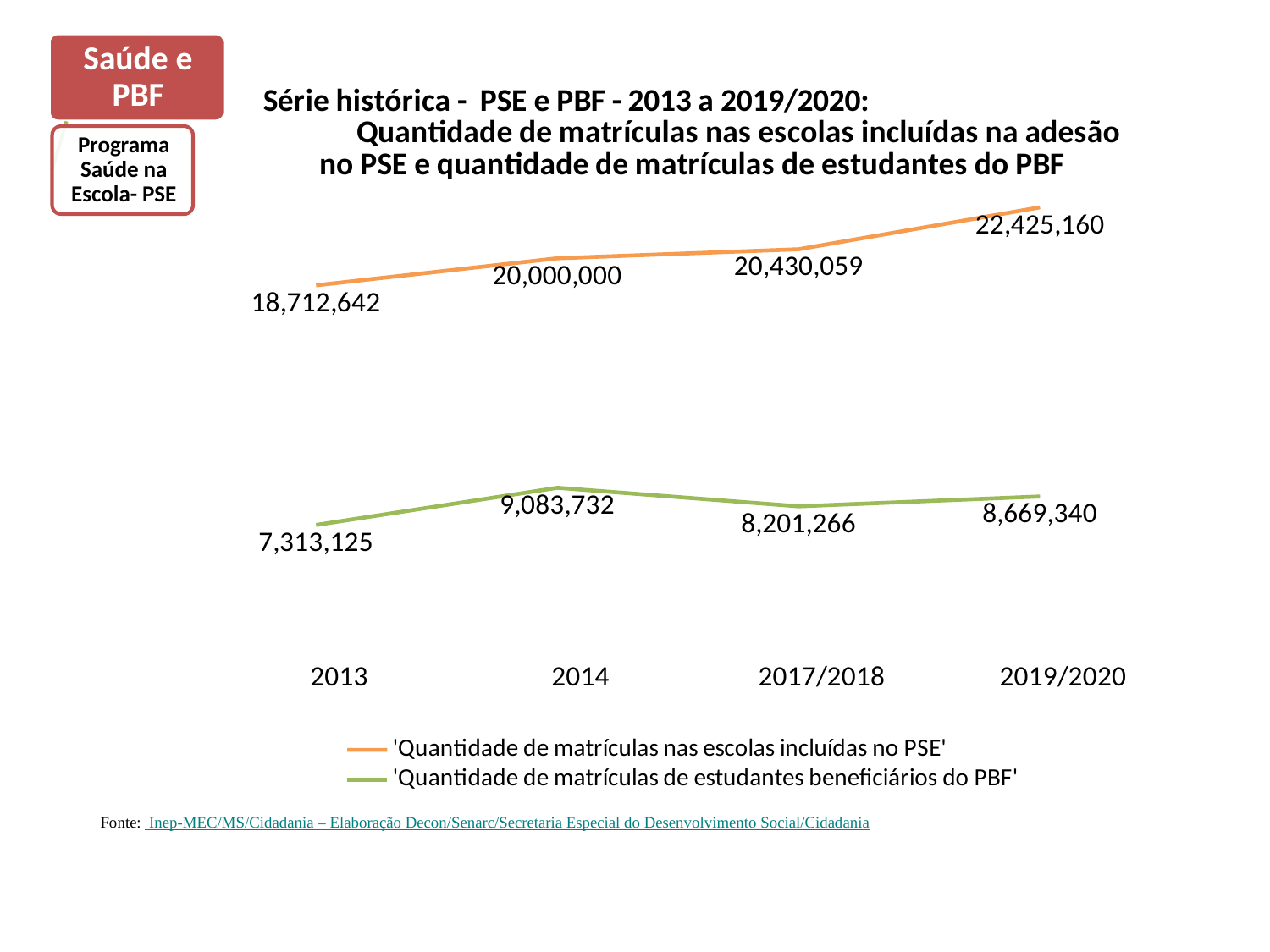
How many points are plotted along the x axis for each series? 4 What is the value of 'Quantidade de matrículas nas escolas incluídas no PSE' in 2013? 18,712,642 How many series does the legend list? 2 In which year is 'Quantidade de matrículas nas escolas incluídas no PSE' lowest? 2013 Which is larger: the PBF value in 2014 or the PBF value in 2019/2020? 2014 What is the value of 'Quantidade de matrículas nas escolas incluídas no PSE' in 2019/2020? 22,425,160 In which period is 'Quantidade de matrículas de estudantes beneficiários do PBF' highest? 2014 What is the value of 'Quantidade de matrículas de estudantes beneficiários do PBF' in 2017/2018? 8,201,266 Does 'Quantidade de matrículas nas escolas incluídas no PSE' rise or fall from 2013 to 2019/2020? rise What colour is the line for 'Quantidade de matrículas de estudantes beneficiários do PBF'? green What type of chart is shown on the slide? line chart What is the difference between the PSE value in 2019/2020 and the PSE value in 2013? 3,712,518